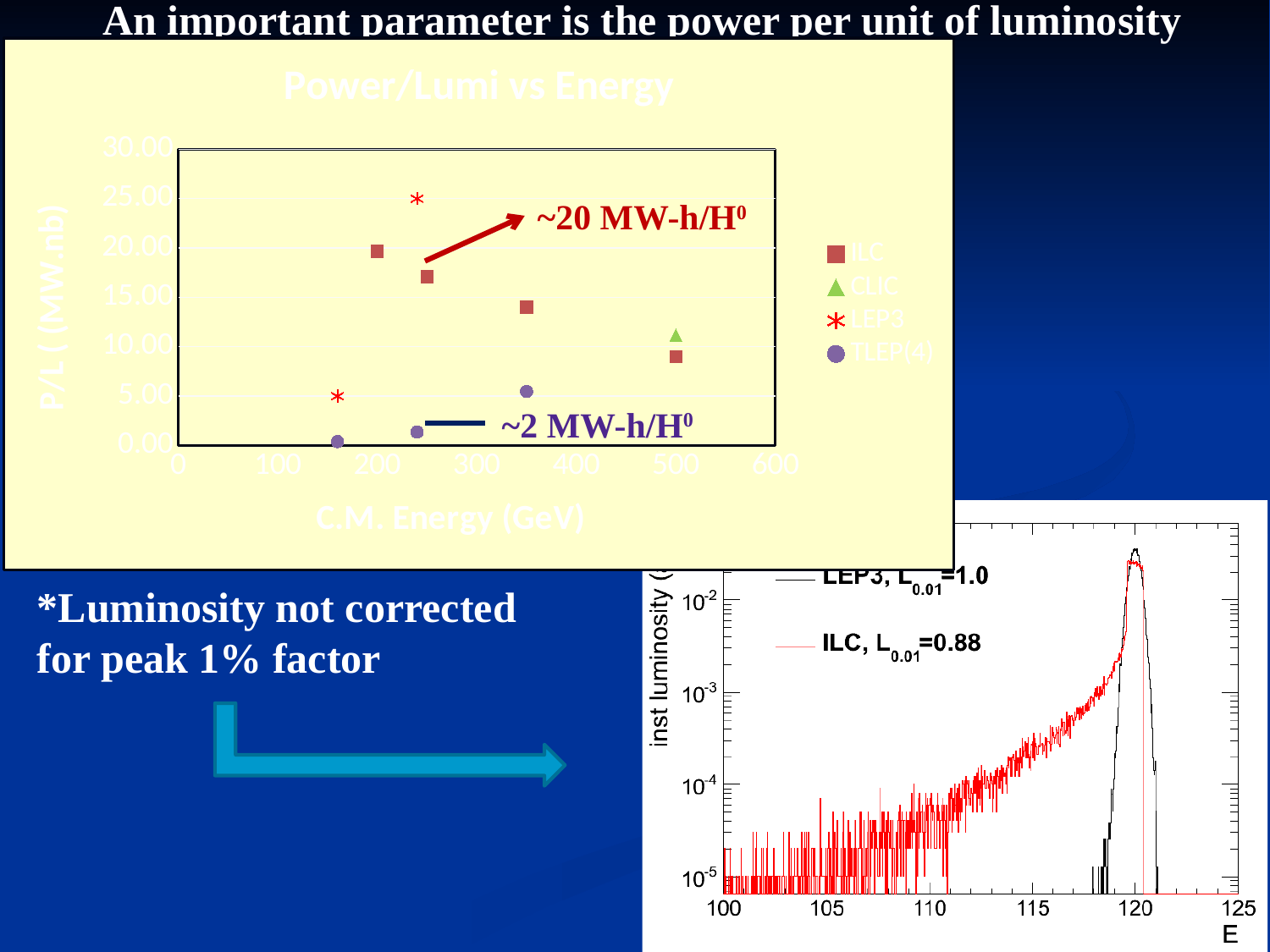
In the 'Power/Lumi vs Energy' chart, is the TLEP(4) point near 160 GeV greater or less than 5? less What kind of chart is the 'Power/Lumi vs Energy' chart? scatter chart In the luminosity spectrum chart at the bottom right, which series has L_0.01=0.88? ILC In the 'Power/Lumi vs Energy' chart, which series has the lowest plotted point? TLEP(4) How many series does the legend of the 'Power/Lumi vs Energy' chart list? 4 In the 'Power/Lumi vs Energy' chart, how many ILC points are plotted? 4 In the 'Power/Lumi vs Energy' chart, is the CLIC point greater or less than 15? less In the 'Power/Lumi vs Energy' chart, which series has the highest plotted point? LEP3 What is the x-axis label of the 'Power/Lumi vs Energy' chart? C.M. Energy (GeV) In the 'Power/Lumi vs Energy' chart, is the highest LEP3 point greater or less than 20? greater In the 'Power/Lumi vs Energy' chart, do the ILC values rise or fall as C.M. Energy increases? fall